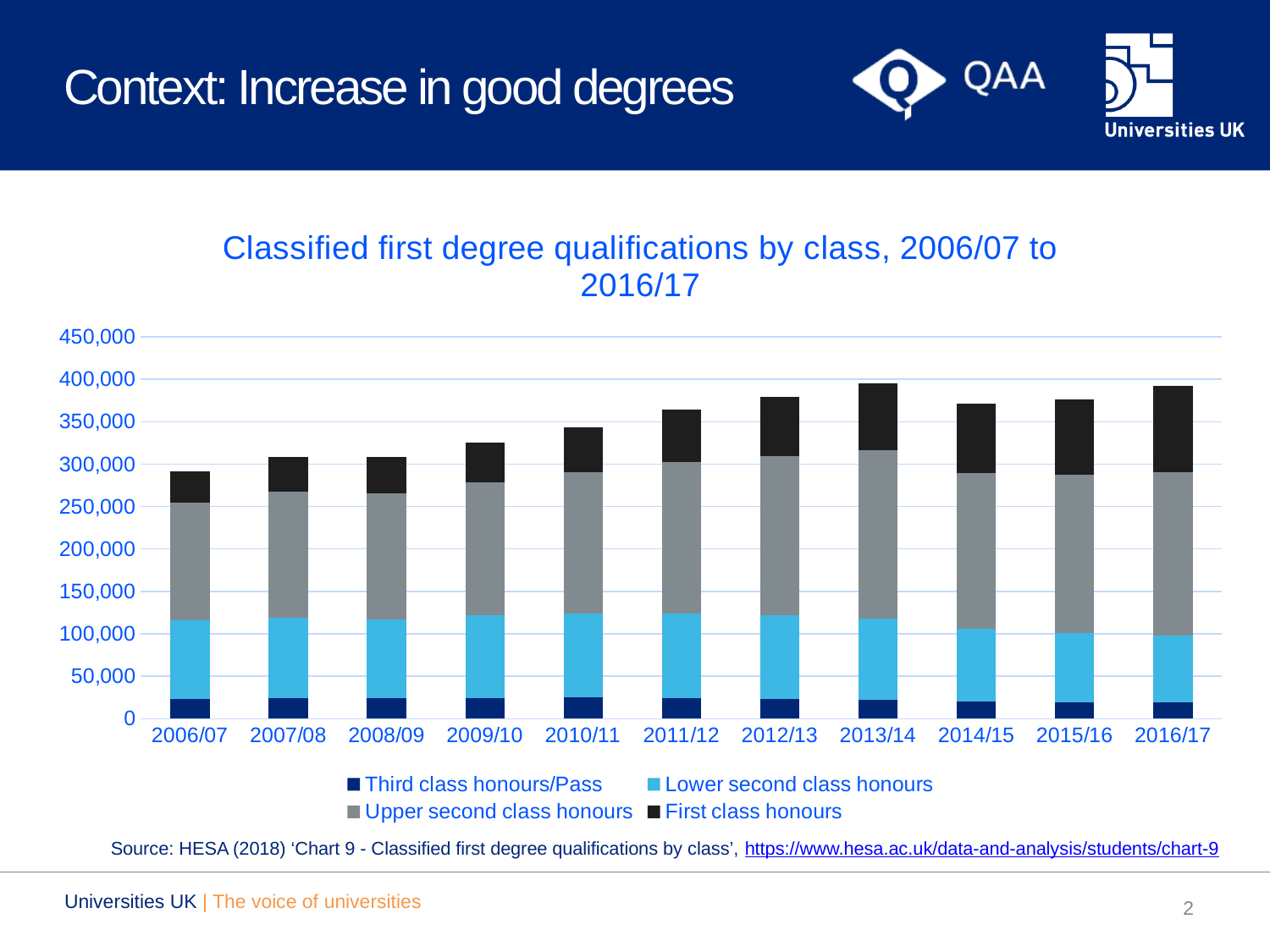
How many series does the chart's legend list? 4 Which total bar is larger, 2006/07 or 2016/17? 2016/17 What kind of chart is shown on the slide? Stacked bar chart What is the title of the chart? Classified first degree qualifications by class, 2006/07 to 2016/17 Is the total bar for 2006/07 greater or less than 300,000? less Which year has the lowest total bar in the chart? 2006/07 How many academic years are shown on the x axis of the chart? 11 Is the total bar for 2010/11 greater or less than 300,000? greater Do the total bars generally rise or fall from 2006/07 to 2016/17? rise Is the total bar for 2016/17 greater or less than 350,000? greater Which series is shown in black in the chart? First class honours